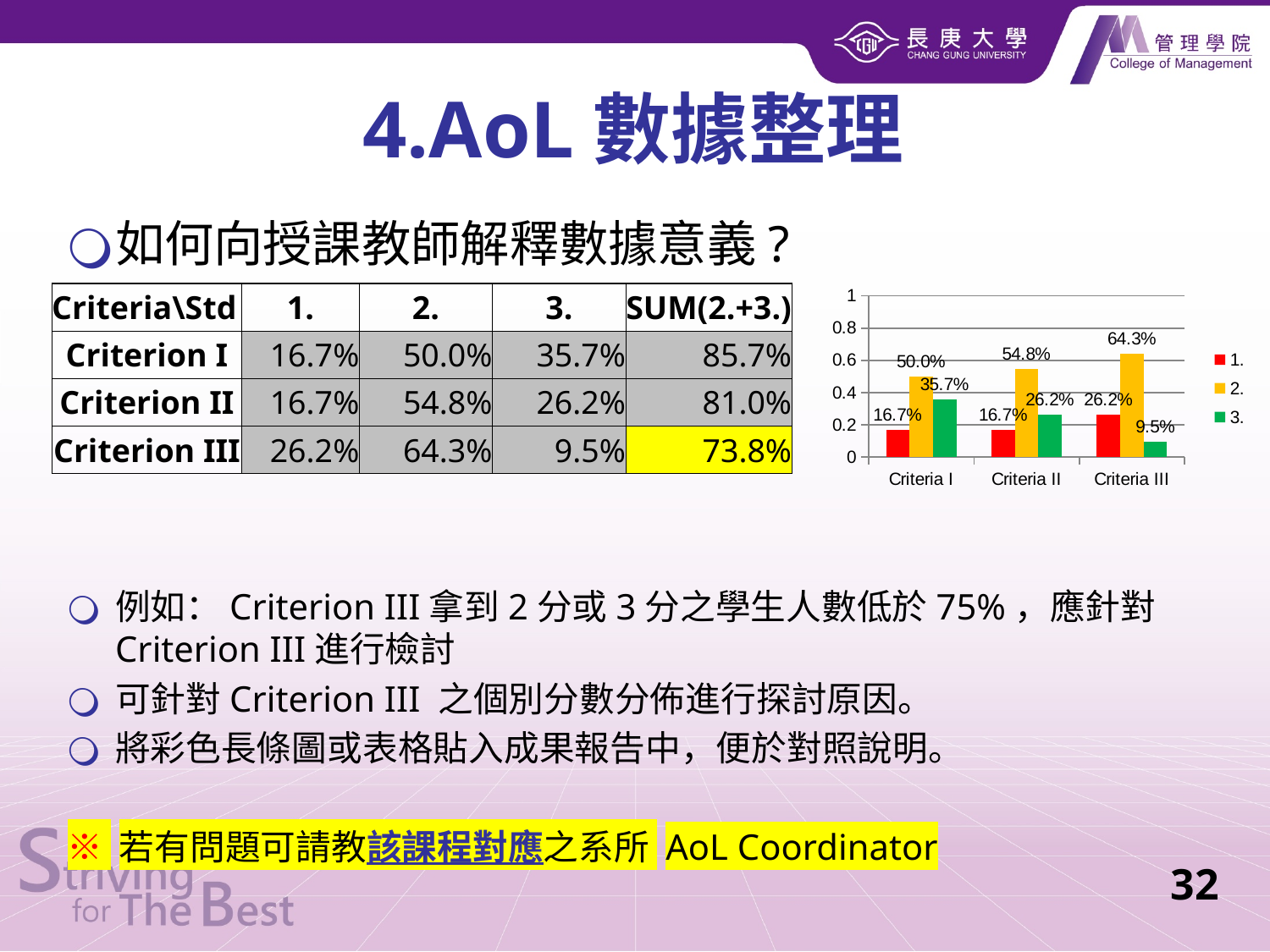
Does the value of series 2. rise or fall from Criteria I to Criteria III in the chart? rise How many series does the chart legend list? 3 Which category has the highest value for series 2. in the chart? Criteria III What colour are the bars for series 2. in the chart? yellow How many categories are shown on the x axis of the chart? 3 What is the value of series 1. for Criteria II in the chart? 16.7% Which category has the lowest value for series 3. in the chart? Criteria III In the chart, is the series 3. value for Criteria II larger or smaller than the series 3. value for Criteria I? smaller What is the difference between the series 2. values for Criteria III and Criteria I in the chart? 14.3% What kind of chart is shown on the slide? bar chart What is the value of series 2. for Criteria III in the chart? 64.3% What is the value of series 3. for Criteria I in the chart? 35.7%